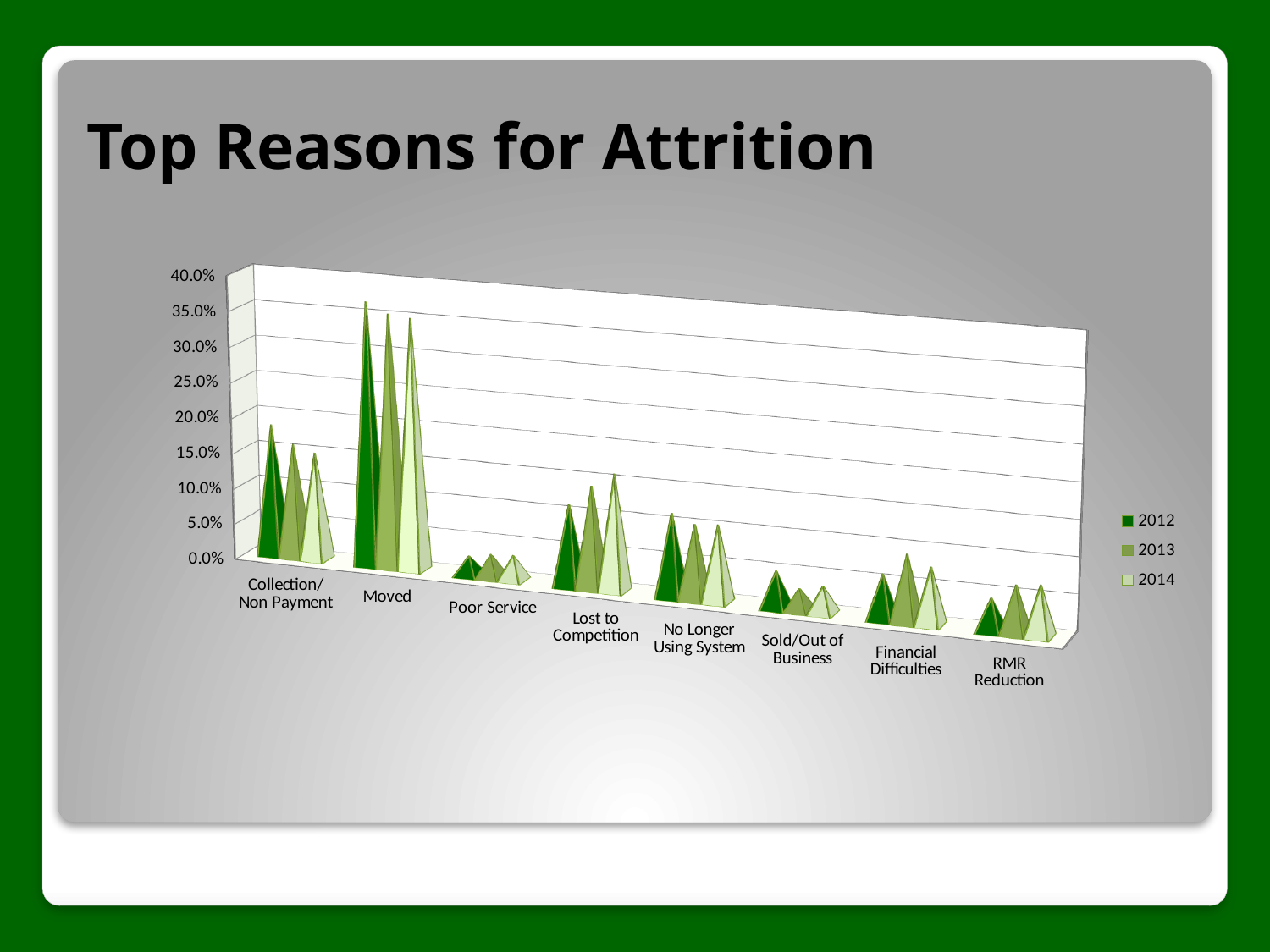
How many attrition reason categories are shown on the x axis? 8 What is the title of the slide containing the chart? Top Reasons for Attrition Is the 2012 value for Moved greater or less than 20.0%? greater How many series does the legend list? 3 Which years are listed in the chart legend? 2012, 2013, 2014 For Collection/Non Payment, do the values rise or fall from 2012 to 2014? fall Is the 2012 value for Collection/Non Payment greater or less than 10.0%? greater Is the 2013 value for Sold/Out of Business greater or less than 10.0%? less Which category has the highest values across all three years? Moved For 2012, which is larger: Moved or Collection/Non Payment? Moved What kind of chart is shown on the slide? 3D bar chart